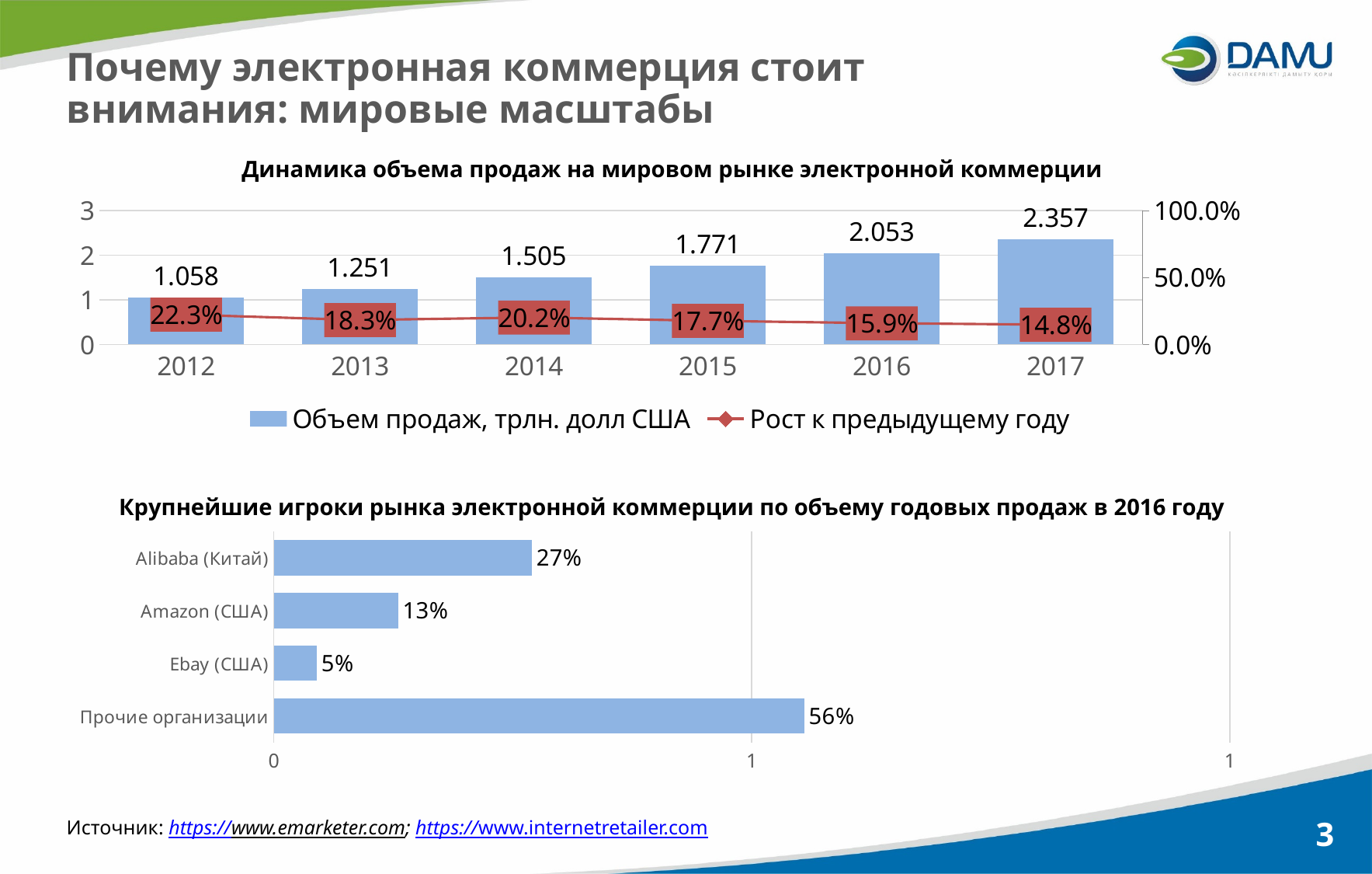
In the top chart, which year has the highest sales volume? 2017 What type of chart is the bottom chart? bar chart In the top chart, what is the difference in sales volume between 2017 and 2016? 0.304 In the bottom chart, which category has the smallest value? Ebay (США) In the top chart, what is the growth to the previous year (Рост к предыдущему году) for 2012? 22.3% In the top chart, which year has the lowest growth to the previous year? 2017 In the bottom chart 'Крупнейшие игроки рынка электронной коммерции по объему годовых продаж в 2016 году', what is the share for Amazon (США)? 13% In the top chart, how many years are shown on the x axis? 6 In the top chart 'Динамика объема продаж на мировом рынке электронной коммерции', what is the sales volume (Объем продаж, трлн. долл США) for 2014? 1.505 In the top chart, does the sales volume rise or fall from 2012 to 2017? rise In the top chart, is the growth to the previous year higher in 2013 or in 2014? 2014 In the top chart, how many series does the legend list? 2